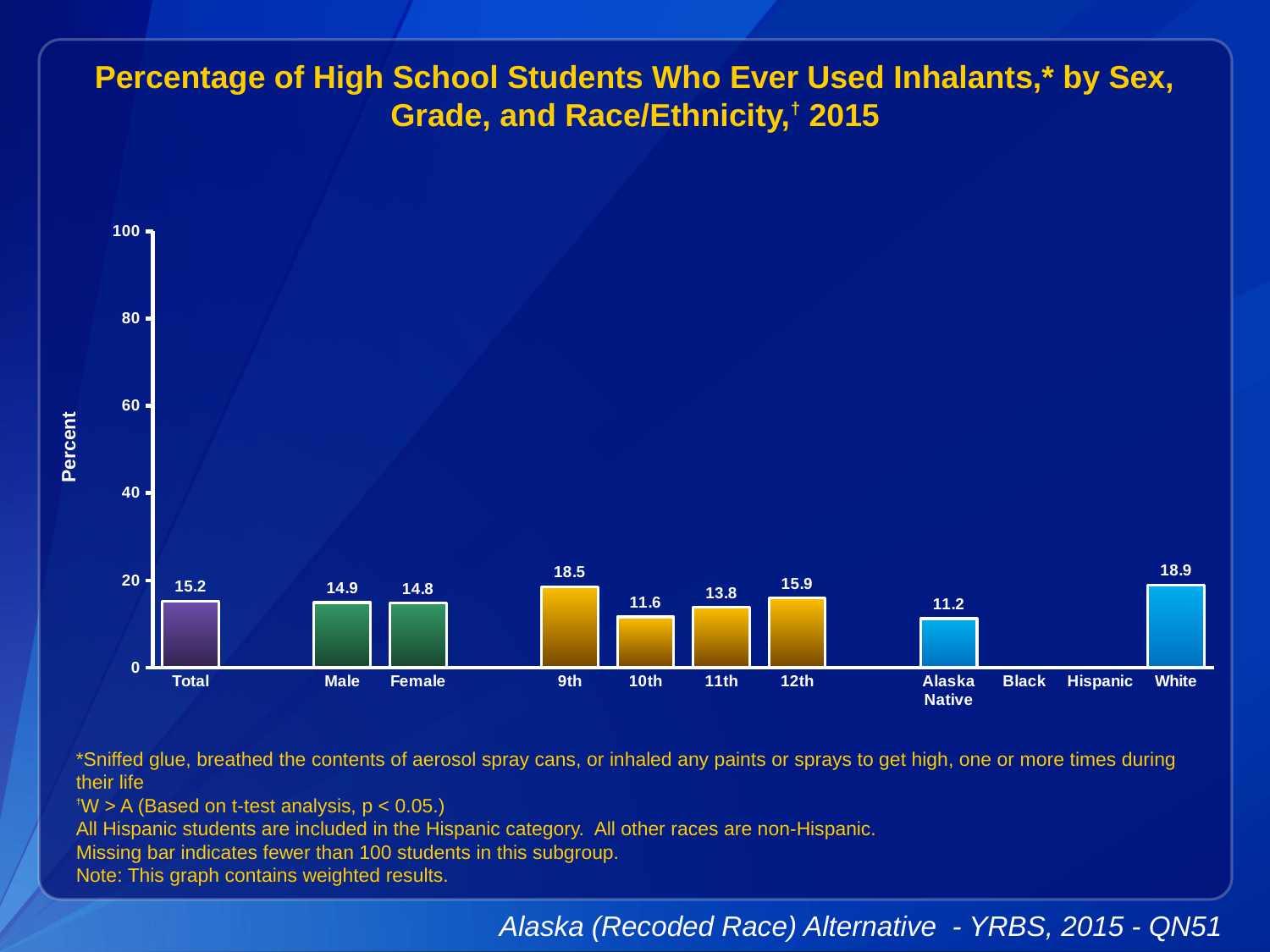
Which race/ethnicity categories have no bar shown? Black and Hispanic How many categories have a bar plotted? 9 Which is larger, the value for 11th grade or 12th grade? 12th What is the difference between the values for 9th and 10th grade? 6.9 What is the label on the y axis? Percent What is the value for 10th grade students? 11.6 Which category has the highest value? White Which grade has the lowest value? 10th What kind of chart is shown? bar chart What is the value for Total? 15.2 Is the value for Alaska Native greater or less than 20? less What is the value for White students? 18.9